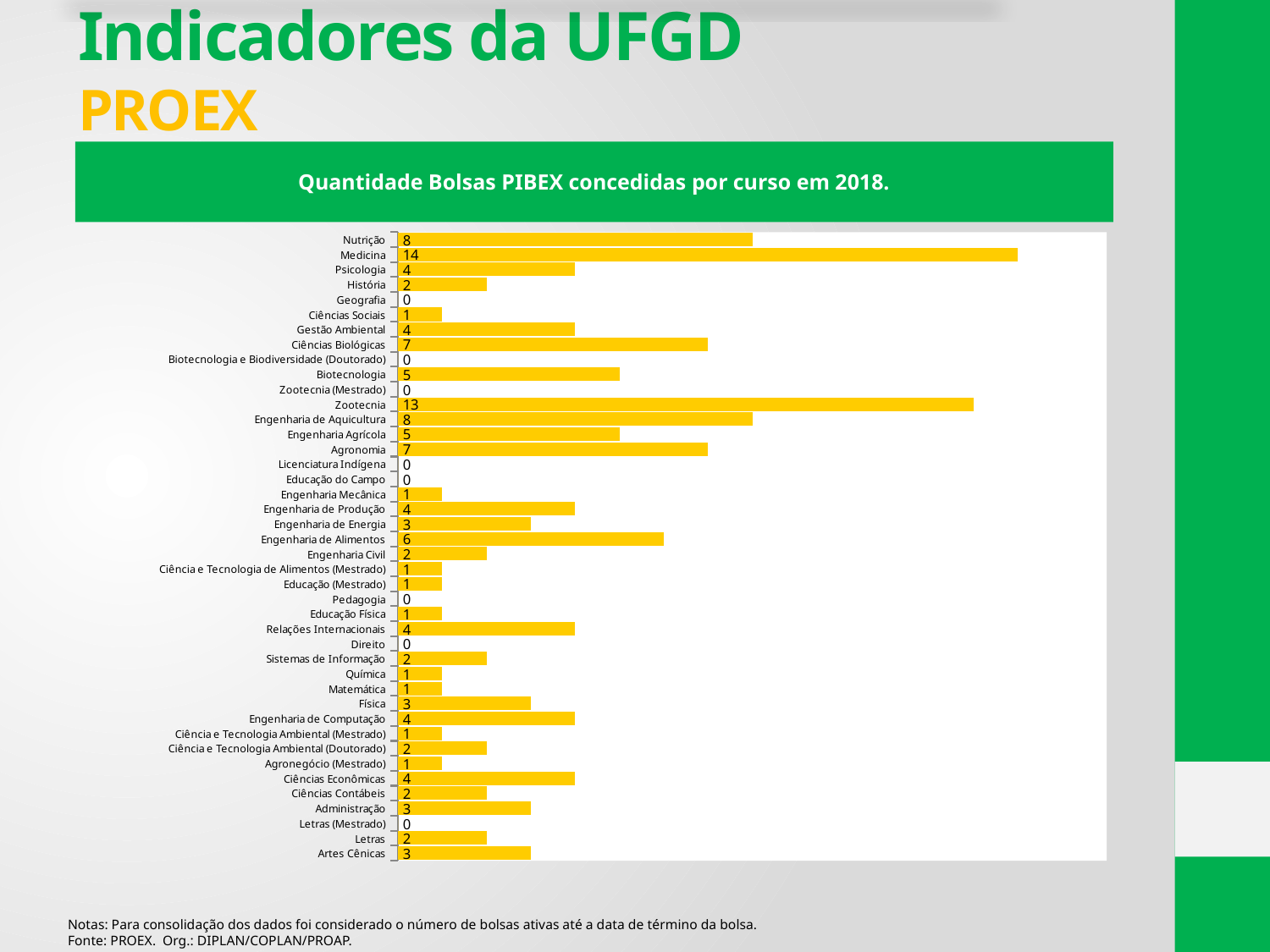
What is the difference between the number of scholarships for Nutrição and História? 6 How many courses are listed in the chart? 42 How many PIBEX scholarships were granted to Artes Cênicas? 3 How many PIBEX scholarships were granted to Engenharia de Alimentos? 6 How many PIBEX scholarships were granted to Medicina? 14 How many courses received 0 PIBEX scholarships? 8 What is the difference between the number of scholarships for Medicina and Zootecnia? 1 What type of chart is shown on the slide? Bar chart What is the title of the chart? Quantidade Bolsas PIBEX concedidas por curso em 2018. Which course received the highest number of PIBEX scholarships? Medicina How many PIBEX scholarships were granted to Zootecnia? 13 Which received more PIBEX scholarships, Ciências Biológicas or Biotecnologia? Ciências Biológicas